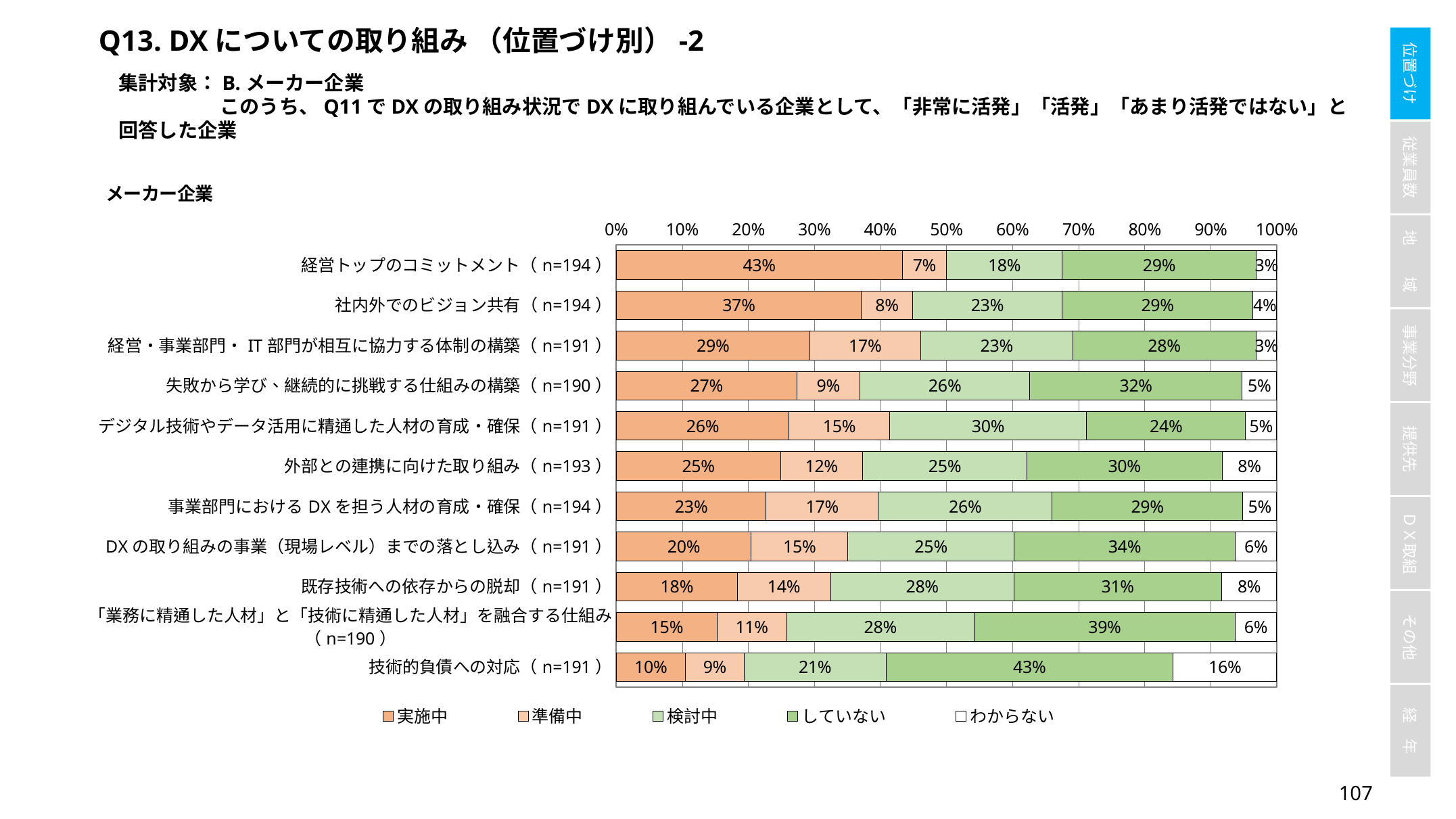
How many categories (items) are plotted in the chart? 11 Which category has the highest 実施中 value? 経営トップのコミットメント What type of chart is shown on the slide? Stacked horizontal bar chart Which category has the highest わからない value? 技術的負債への対応 What is the していない value for 技術的負債への対応? 43% How many series does the legend list? 5 Which category has the lowest 実施中 value? 技術的負債への対応 Which is larger: the 準備中 value for 経営・事業部門・IT部門が相互に協力する体制の構築 or for 失敗から学び、継続的に挑戦する仕組みの構築? 経営・事業部門・IT部門が相互に協力する体制の構築 What is the difference between the 実施中 values for 経営トップのコミットメント and 社内外でのビジョン共有? 6% What is the combined 実施中 and 準備中 share for 外部との連携に向けた取り組み? 37% What is the 実施中 value for 経営トップのコミットメント? 43% What is the 検討中 value for デジタル技術やデータ活用に精通した人材の育成・確保? 30%